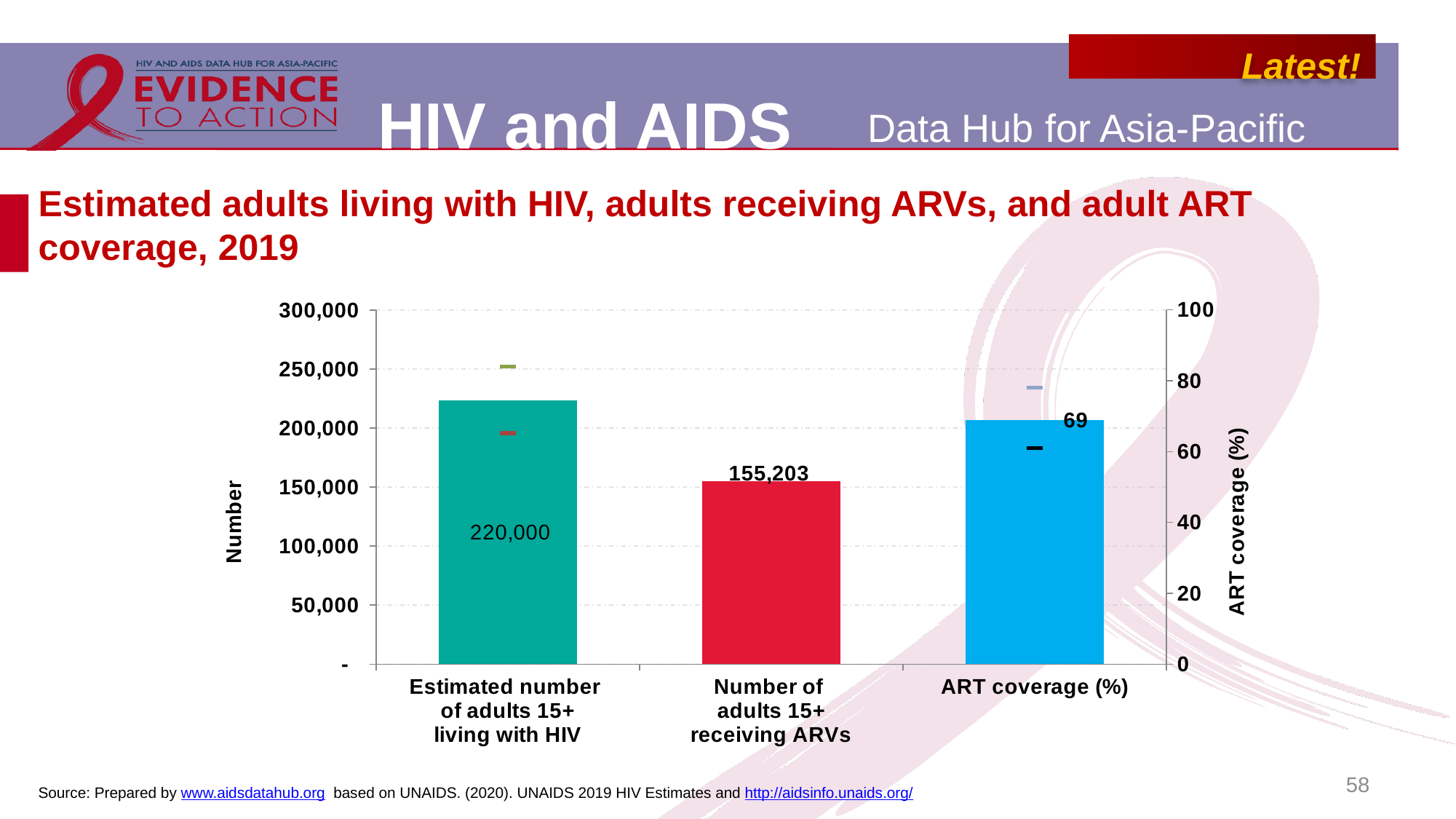
How many categories are shown on the x axis of the chart? 3 What is the difference between the estimated number of adults 15+ living with HIV and the number of adults 15+ receiving ARVs? 64,797 Is the value for the number of adults 15+ receiving ARVs greater or less than 200,000? less Which is larger: the estimated number of adults 15+ living with HIV or the number of adults 15+ receiving ARVs? Estimated number of adults 15+ living with HIV Is the ART coverage (%) value greater or less than 60 on the right-hand axis? greater What is the title of the right-hand vertical axis of the chart? ART coverage (%) What is the ART coverage (%) value shown on the chart? 69 What is the number of adults 15+ receiving ARVs shown on the chart? 155,203 What is the estimated number of adults 15+ living with HIV shown on the chart? 220,000 What is the title of the chart on the slide? Estimated adults living with HIV, adults receiving ARVs, and adult ART coverage, 2019 What kind of chart is shown on the slide? Bar chart